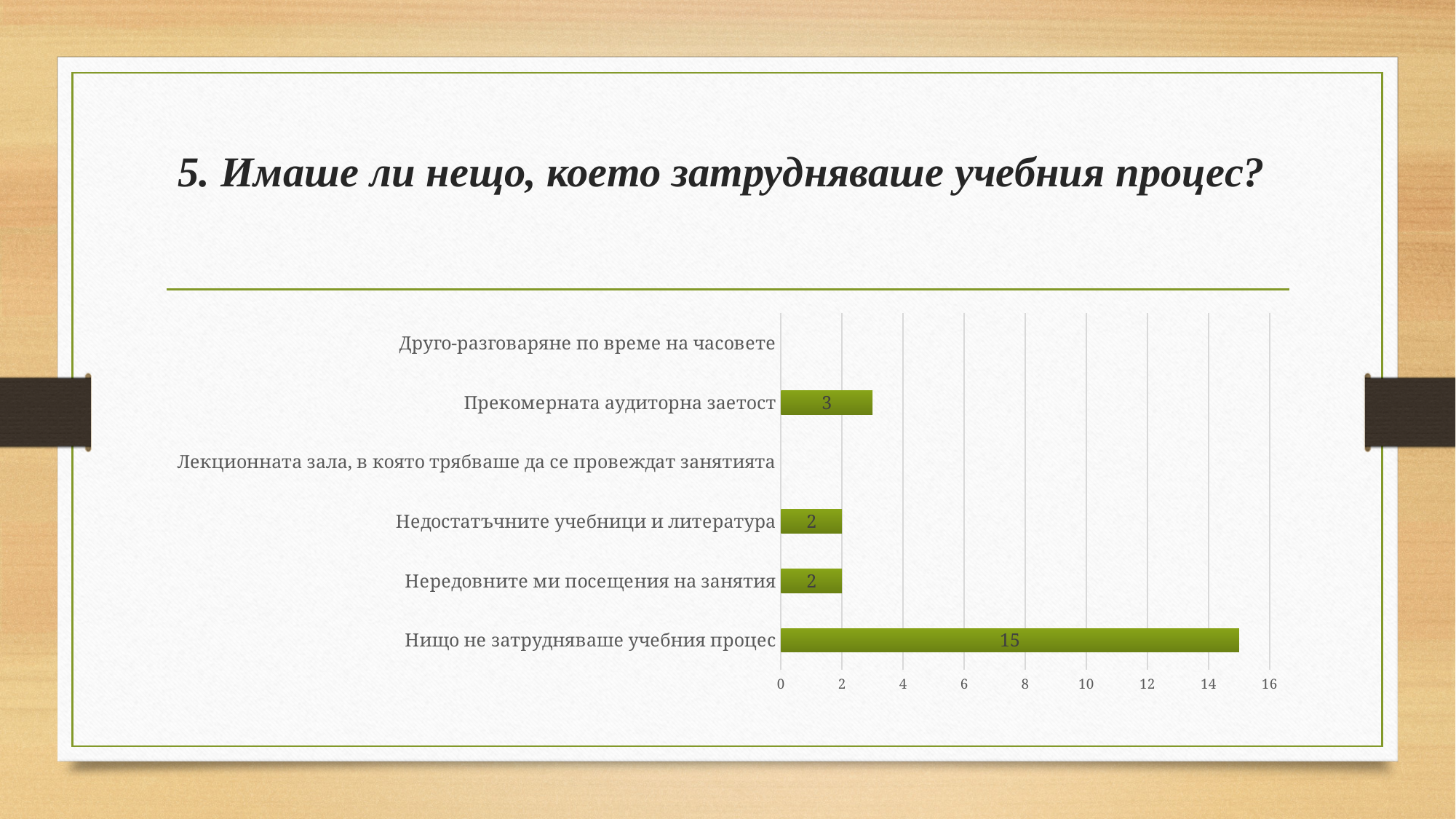
What is the value for "Недостатъчните учебници и литература"? 2 Which is larger: the value for "Прекомерната аудиторна заетост" or the value for "Нередовните ми посещения на занятия"? Прекомерната аудиторна заетост What is the difference between the values for "Нищо не затрудняваше учебния процес" and "Прекомерната аудиторна заетост"? 12 What is the value for "Нищо не затрудняваше учебния процес"? 15 What is the title of the slide? 5. Имаше ли нещо, което затрудняваше учебния процес? Is the value for "Нищо не затрудняваше учебния процес" greater or less than 10? greater What kind of chart is shown on the slide? bar chart What is the value for "Нередовните ми посещения на занятия"? 2 What is the value for "Прекомерната аудиторна заетост"? 3 How many categories are listed on the vertical axis of the chart? 6 What is the difference between the values for "Прекомерната аудиторна заетост" and "Недостатъчните учебници и литература"? 1 Which category has the highest value? Нищо не затрудняваше учебния процес